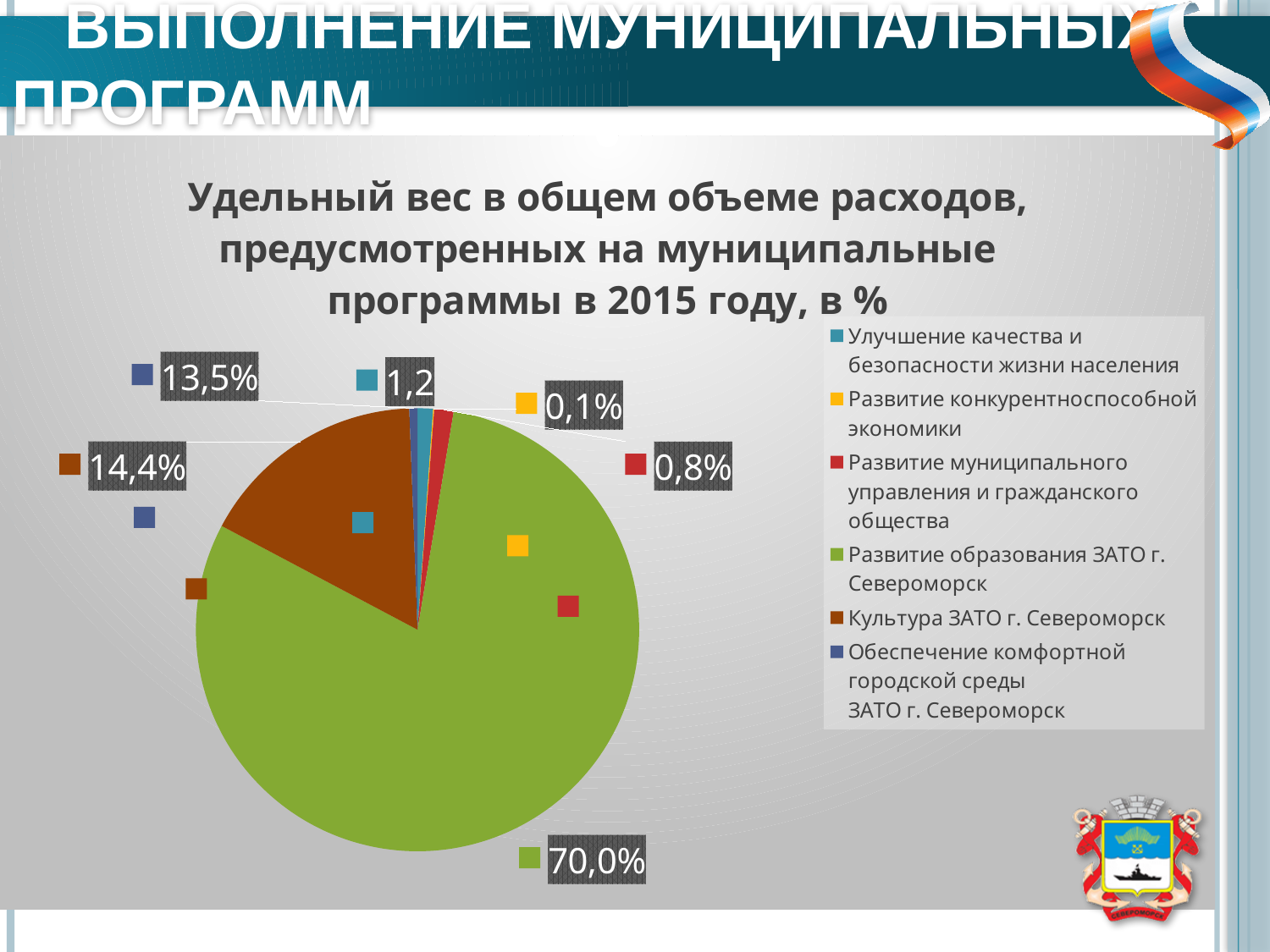
How many categories does the legend list? 6 Which category has the largest share of the pie? Развитие образования ЗАТО г. Североморск What is the share for Развитие образования ЗАТО г. Североморск? 70,0% What kind of chart is shown on the slide? pie chart What is the share for Обеспечение комфортной городской среды ЗАТО г. Североморск? 13,5% What is the share for Развитие муниципального управления и гражданского общества? 0,8% What value is labelled for Улучшение качества и безопасности жизни населения? 1,2 What is the share for Культура ЗАТО г. Североморск? 14,4% What colour is the slice for Развитие образования ЗАТО г. Североморск? green What is the share for Развитие конкурентноспособной экономики? 0,1% Which is larger: the share for Культура ЗАТО г. Североморск or for Обеспечение комфортной городской среды ЗАТО г. Североморск? Культура ЗАТО г. Североморск Which category has the smallest share of the pie? Развитие конкурентноспособной экономики